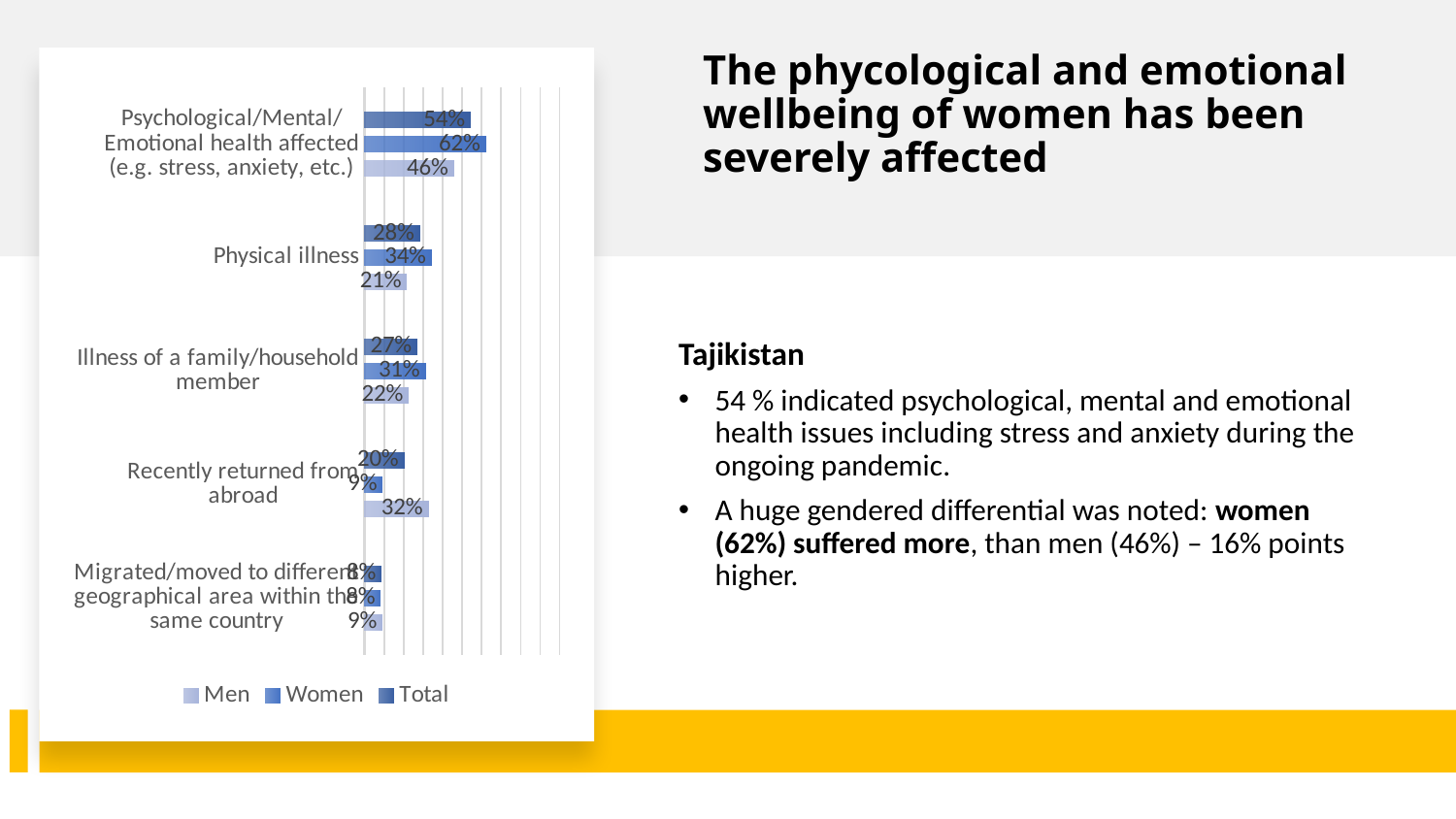
Which category has the highest Women value? Psychological/Mental/Emotional health affected Which category has the lowest Total value? Migrated/moved to different geographical area within the same country What is the value for Women in the Psychological/Mental/Emotional health affected category? 62% In the Recently returned from abroad category, which is larger, the Men value or the Women value? Men Which series is shown in the darkest blue colour? Total How many series does the legend list? 3 What is the difference between the Women and Men values for Psychological/Mental/Emotional health affected? 16% What is the value for Men in the Recently returned from abroad category? 32% What is the Total value for Illness of a family/household member? 27% How many categories are shown on the chart? 5 What is the value for Men in the Physical illness category? 21% What kind of chart is shown on the slide? Bar chart